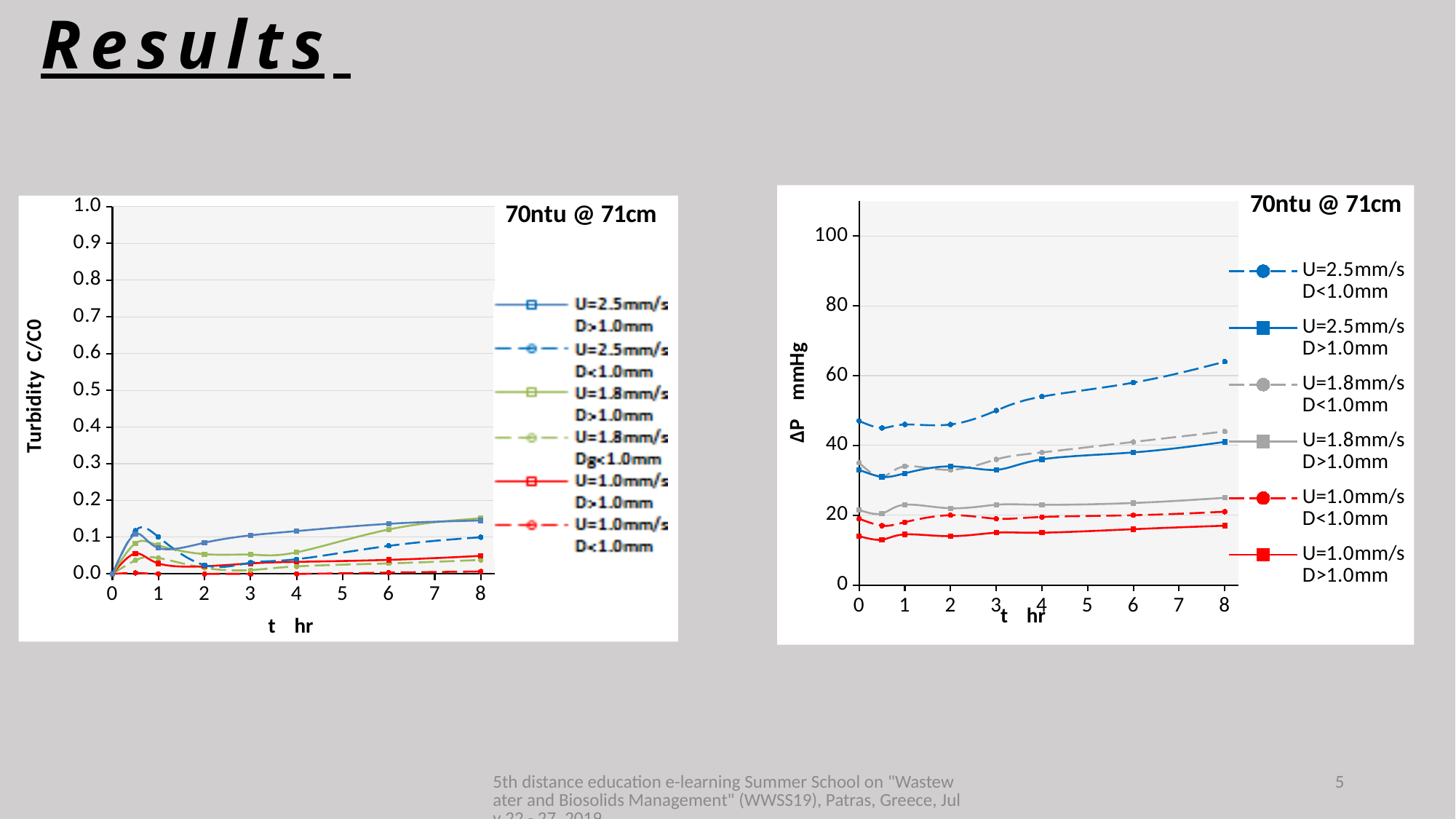
In the left chart (Turbidity C/C0), is the value for U=2.5mm/s D>1.0mm at t = 8 hr greater or less than 0.2? less In the right chart (ΔP mmHg), does the U=2.5mm/s D<1.0mm series rise or fall from t = 2 hr to t = 8 hr? rise What kind of chart is the left chart (Turbidity C/C0)? line chart How many series does the legend of the right chart (ΔP mmHg) list? 6 How many series does the legend of the left chart (Turbidity C/C0) list? 6 What kind of chart is the right chart (ΔP mmHg)? line chart In the right chart (ΔP mmHg), is the value for U=2.5mm/s D<1.0mm at t = 8 hr greater or less than 60? greater In the right chart (ΔP mmHg), at t = 8 hr, which is larger: U=2.5mm/s D<1.0mm or U=1.8mm/s D<1.0mm? U=2.5mm/s D<1.0mm In the right chart (ΔP mmHg), which series has the highest value at t = 8 hr? U=2.5mm/s D<1.0mm What is the title shown on the right chart? 70ntu @ 71cm In the right chart (ΔP mmHg), is the value for U=1.0mm/s D>1.0mm at t = 8 hr greater or less than 20? less In the right chart (ΔP mmHg), which series has the lowest value at t = 8 hr? U=1.0mm/s D>1.0mm